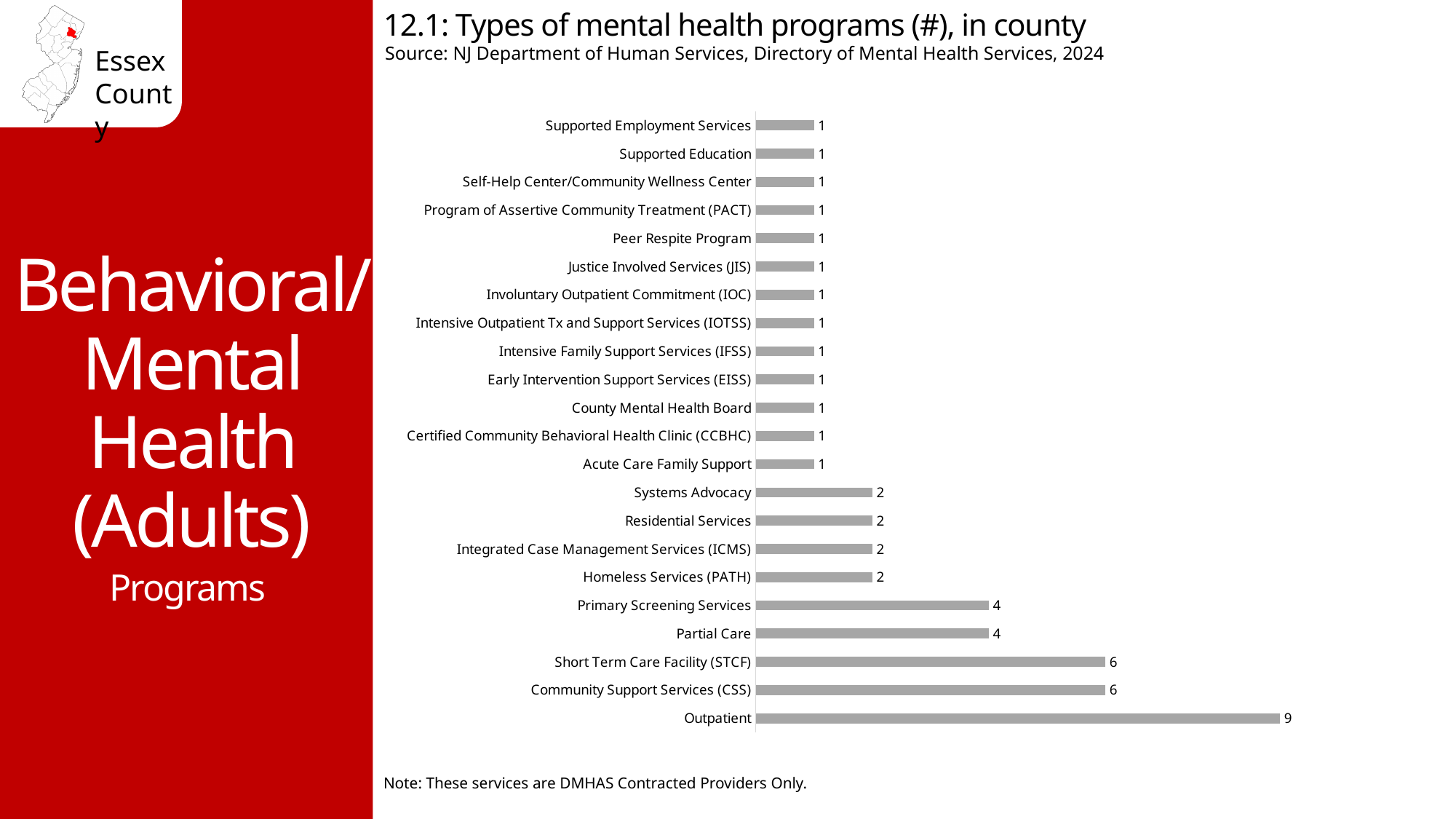
What is the value for Short Term Care Facility (STCF)? 6 What is the difference between the values for Primary Screening Services and Systems Advocacy? 2 What is the value for Partial Care? 4 What kind of chart is shown on the slide? Bar chart What is the value for Outpatient? 9 What is the value for Homeless Services (PATH)? 2 What is the difference between the values for Outpatient and Community Support Services (CSS)? 3 Which program type has the highest value? Outpatient What is the value for Peer Respite Program? 1 What is the title of the chart? 12.1: Types of mental health programs (#), in county Which is larger, the value for Residential Services or the value for Partial Care? Partial Care How many program types are shown in the chart? 22